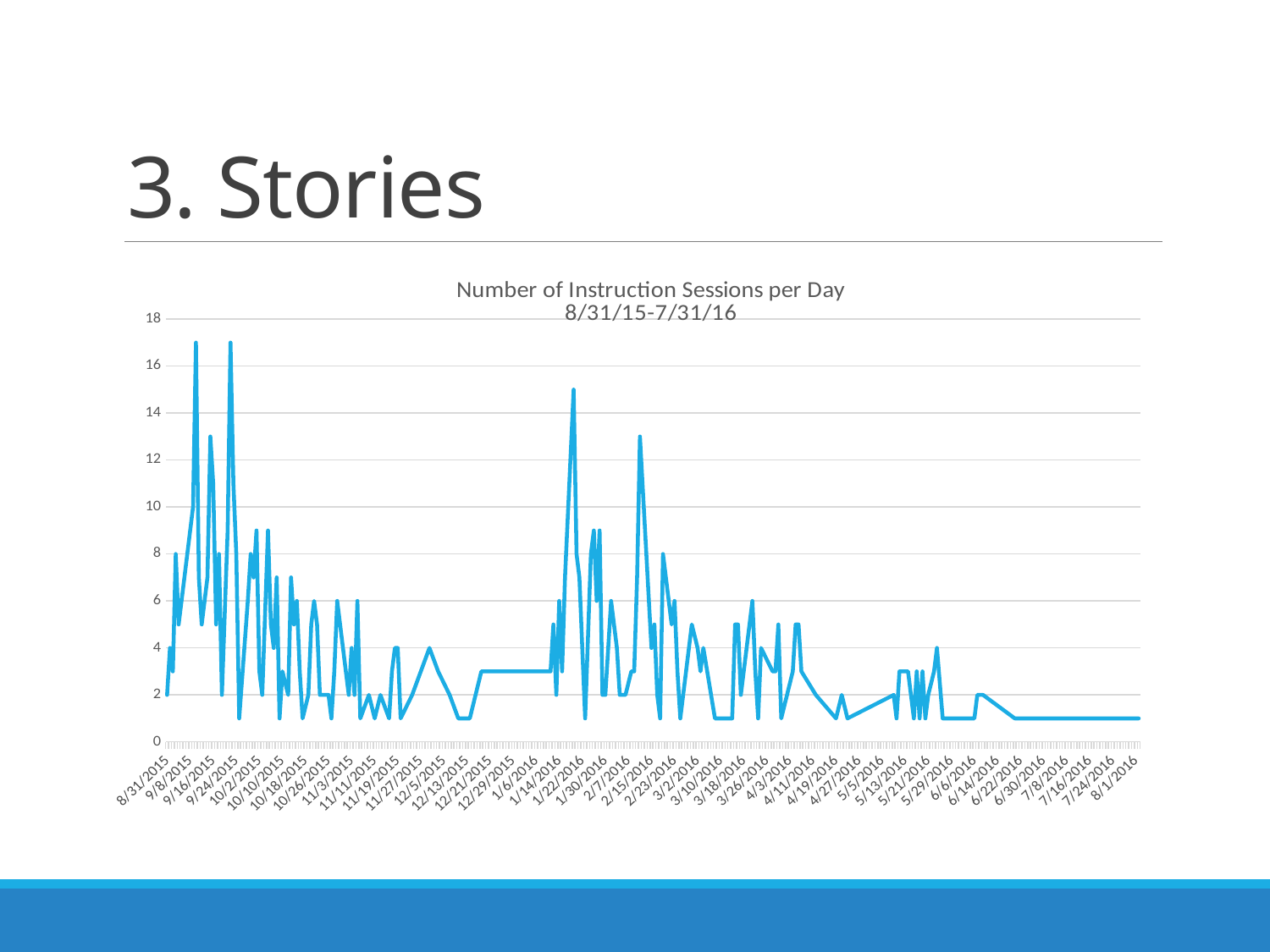
Is the peak near 1/22/2016 greater or less than 14? greater Which is larger: the highest peak in September 2015 or the highest peak in February 2016? the September 2015 peak How many lines are plotted on the chart? 1 Is the peak near 2/15/2016 greater or less than 12? greater Are the values in July 2016 greater or less than 2? less What kind of chart is shown on the slide? line chart What is the highest value shown on the vertical axis of the chart? 18 What is the title of the chart? Number of Instruction Sessions per Day 8/31/15-7/31/16 Overall, do the values rise or fall from the start of the period to the end? fall